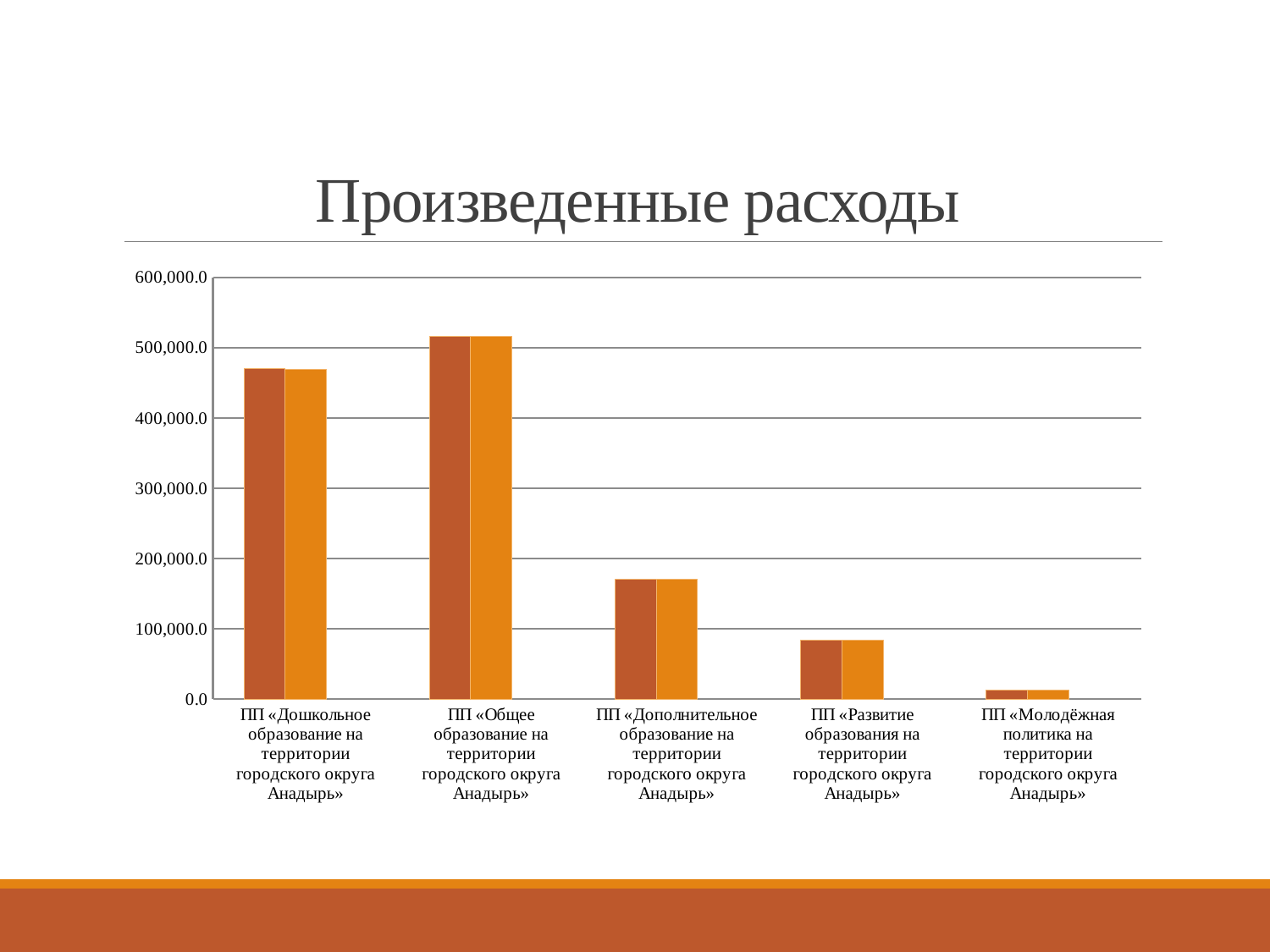
Is the value for ПП «Дошкольное образование на территории городского округа Анадырь» greater or less than 500,000.0? less Which category has the lowest bars in the chart? ПП «Молодёжная политика на территории городского округа Анадырь» Which category has the highest bars in the chart? ПП «Общее образование на территории городского округа Анадырь» Do the values rise or fall along the x axis from ПП «Общее образование» to ПП «Молодёжная политика»? fall Is the value for ПП «Общее образование на территории городского округа Анадырь» greater or less than 500,000.0? greater Which is larger: the value for ПП «Дошкольное образование на территории городского округа Анадырь» or for ПП «Дополнительное образование на территории городского округа Анадырь»? ПП «Дошкольное образование на территории городского округа Анадырь» What is the title of the chart? Произведенные расходы Is the value for ПП «Развитие образования на территории городского округа Анадырь» greater or less than 100,000.0? less What kind of chart is shown on the slide? bar chart How many categories are shown on the x axis of the chart? 5 What is the highest value shown on the y axis of the chart? 600,000.0